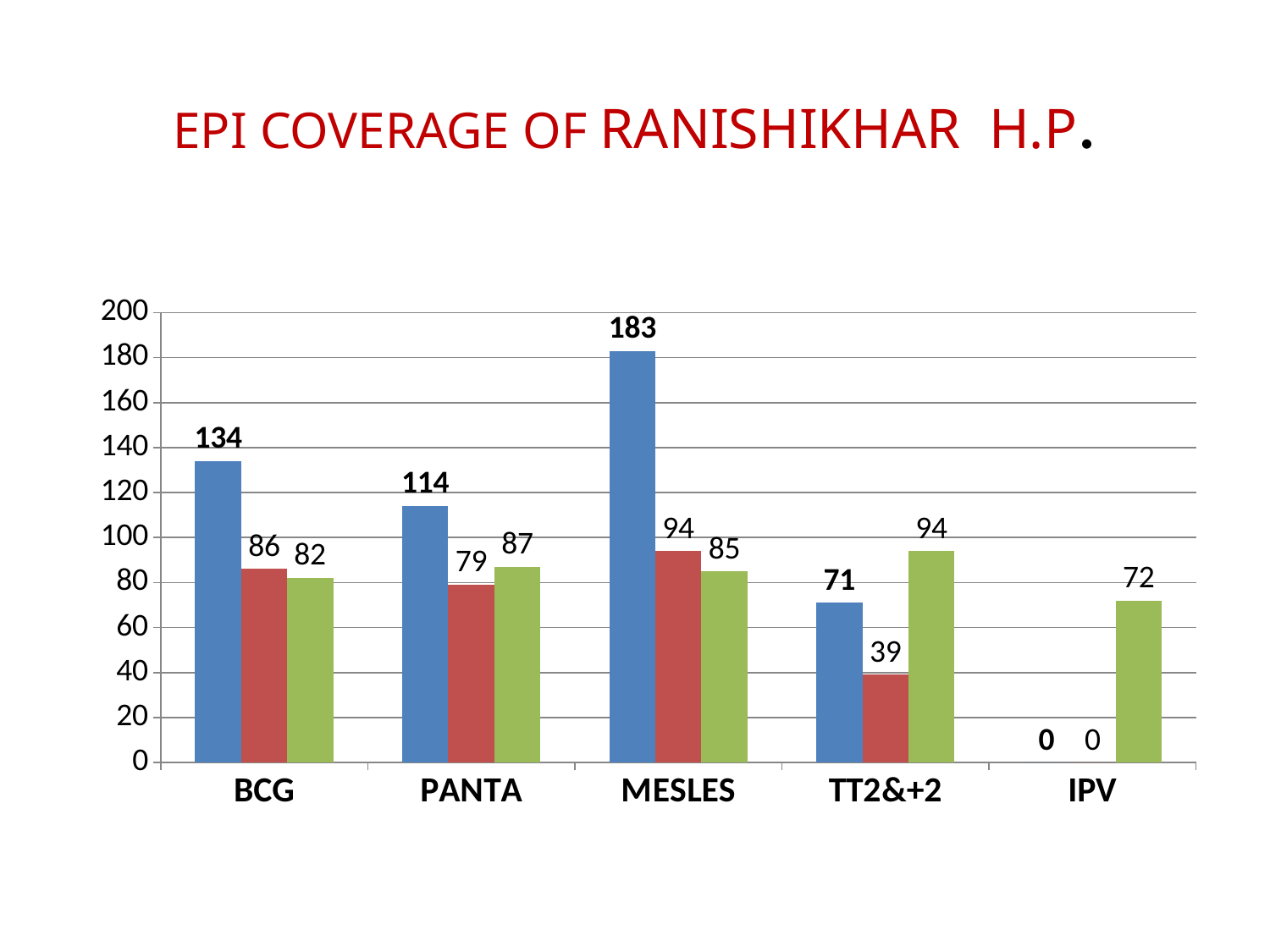
Which category has the lowest red bar? IPV What is the difference between the blue bar for BCG and the blue bar for PANTA? 20 What is the difference between the green bar for TT2&+2 and the red bar for TT2&+2? 55 How many categories are shown on the x axis? 5 Which is larger, the red bar for PANTA or the green bar for PANTA? the green bar (87) What is the value of the red bar for TT2&+2? 39 Which category has the highest blue bar? MESLES What is the title of the chart on the slide? EPI COVERAGE OF RANISHIKHAR H.P. What is the value of the green bar for IPV? 72 What is the value of the blue bar for MESLES? 183 What kind of chart is shown on the slide? bar chart Is the blue bar for TT2&+2 greater or less than 80? less